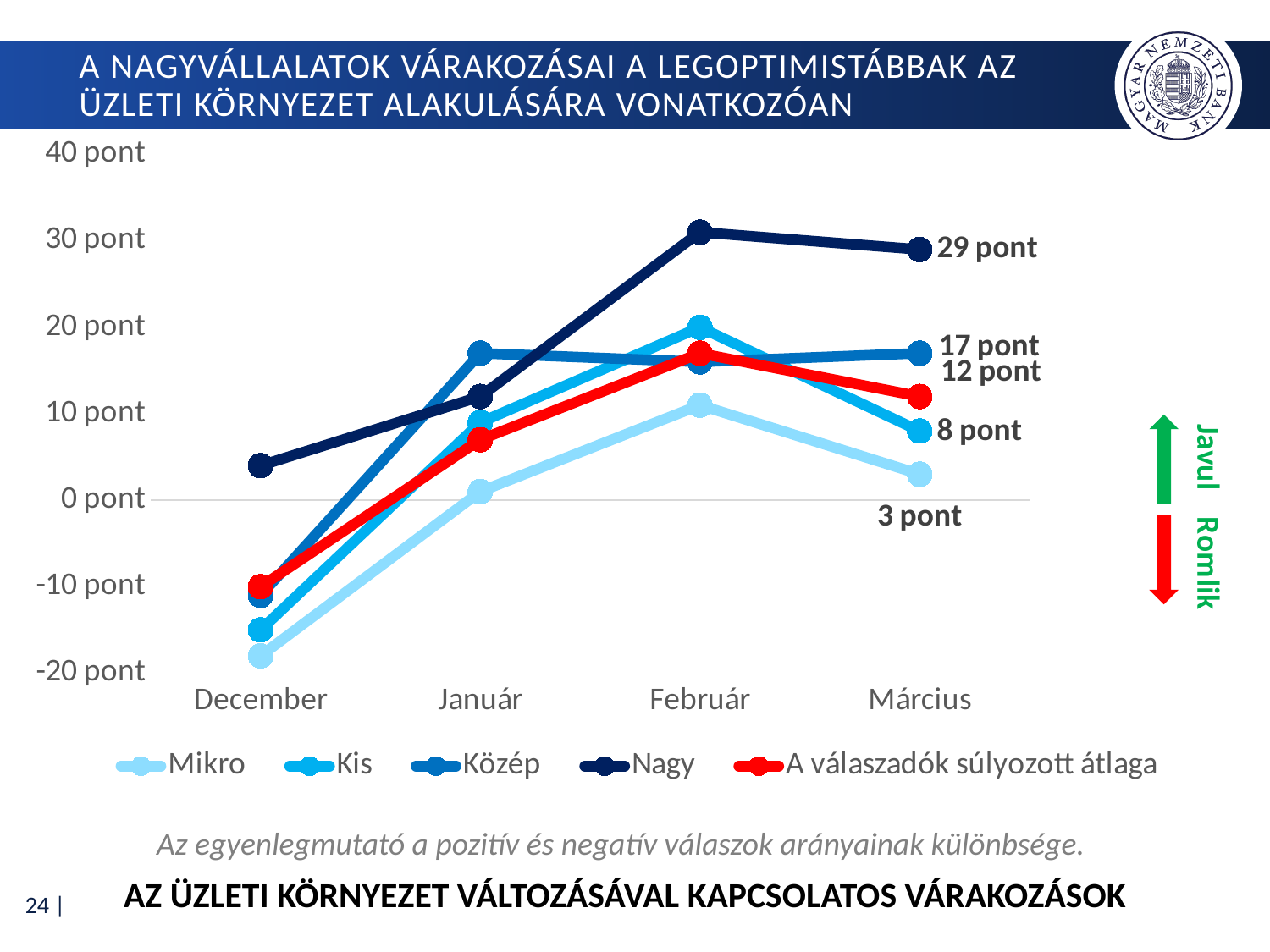
Does the Nagy series rise or fall from December to Február? rise What is the value for Közép in Március? 17 pont How many series does the legend list? 5 What is the value for Kis in Március? 8 pont Which series has the highest value in Március? Nagy Is the value for Mikro in December greater or less than -10 pont? less What is the value for Nagy in Március? 29 pont What is the value for A válaszadók súlyozott átlaga in Március? 12 pont What kind of chart is shown on the slide? line chart Which series has the lowest value in Március? Mikro What is the value for Mikro in Március? 3 pont What is the difference between the Nagy and Mikro values in Március? 26 pont